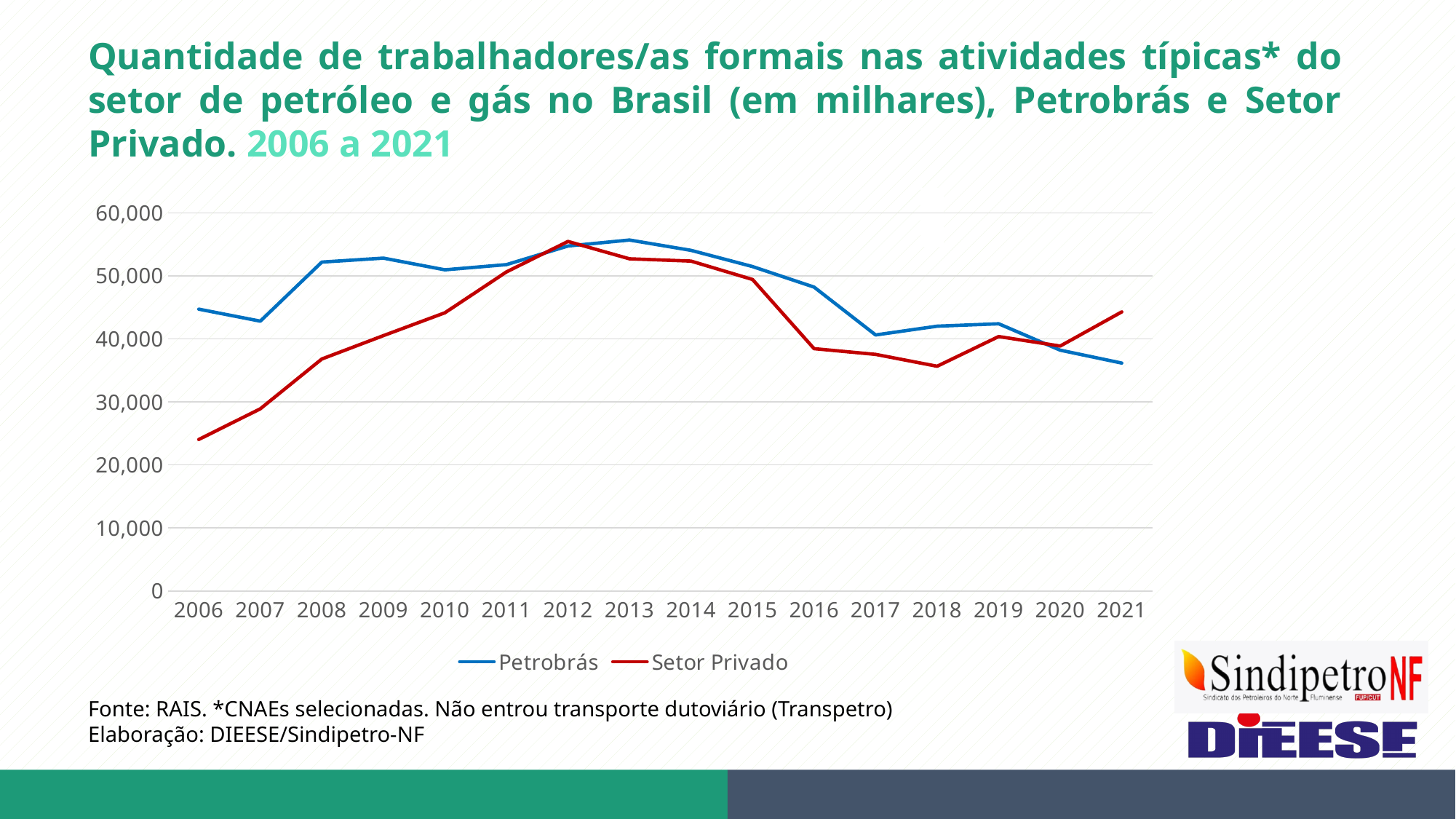
Is the value for Petrobrás in 2021 greater or less than 40,000? less Is the value for Petrobrás in 2013 greater or less than 50,000? greater In which year is the Setor Privado series at its highest? 2012 In 2006, which series has the larger value, Petrobrás or Setor Privado? Petrobrás How many years are shown on the x axis? 16 Does the Setor Privado series rise or fall from 2006 to 2012? rise What kind of chart is shown on the slide? line chart How many series does the legend list? 2 Is the value for Setor Privado in 2006 greater or less than 30,000? less In 2021, which series has the larger value, Petrobrás or Setor Privado? Setor Privado In which year is the Setor Privado series at its lowest? 2006 What colour is the Petrobrás line? blue